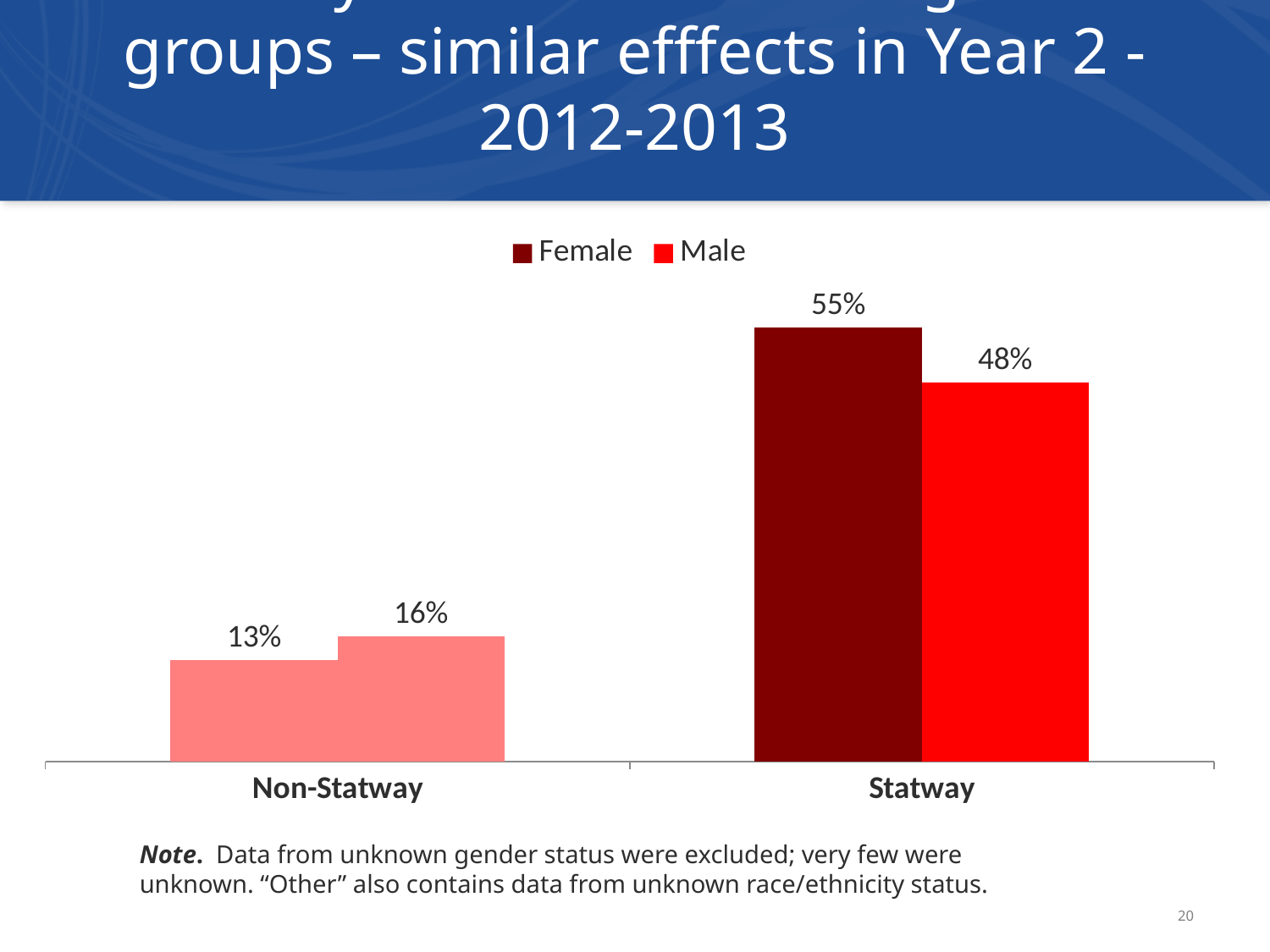
In the Non-Statway group, which is larger, the Female or the Male value? Male How many categories are shown on the x axis? 2 Which bar has the highest value on the chart? Statway Female (55%) What is the value for Female in the Statway group? 55% What is the value for Female in the Non-Statway group? 13% What is the difference between the Female and Male values in the Statway group? 7 percentage points How many series does the legend list? 2 What is the value for Male in the Statway group? 48% What kind of chart is shown on the slide? Bar chart Which bar has the lowest value on the chart? Non-Statway Female (13%) What is the difference between the Male values for Statway and Non-Statway? 32 percentage points What is the value for Male in the Non-Statway group? 16%